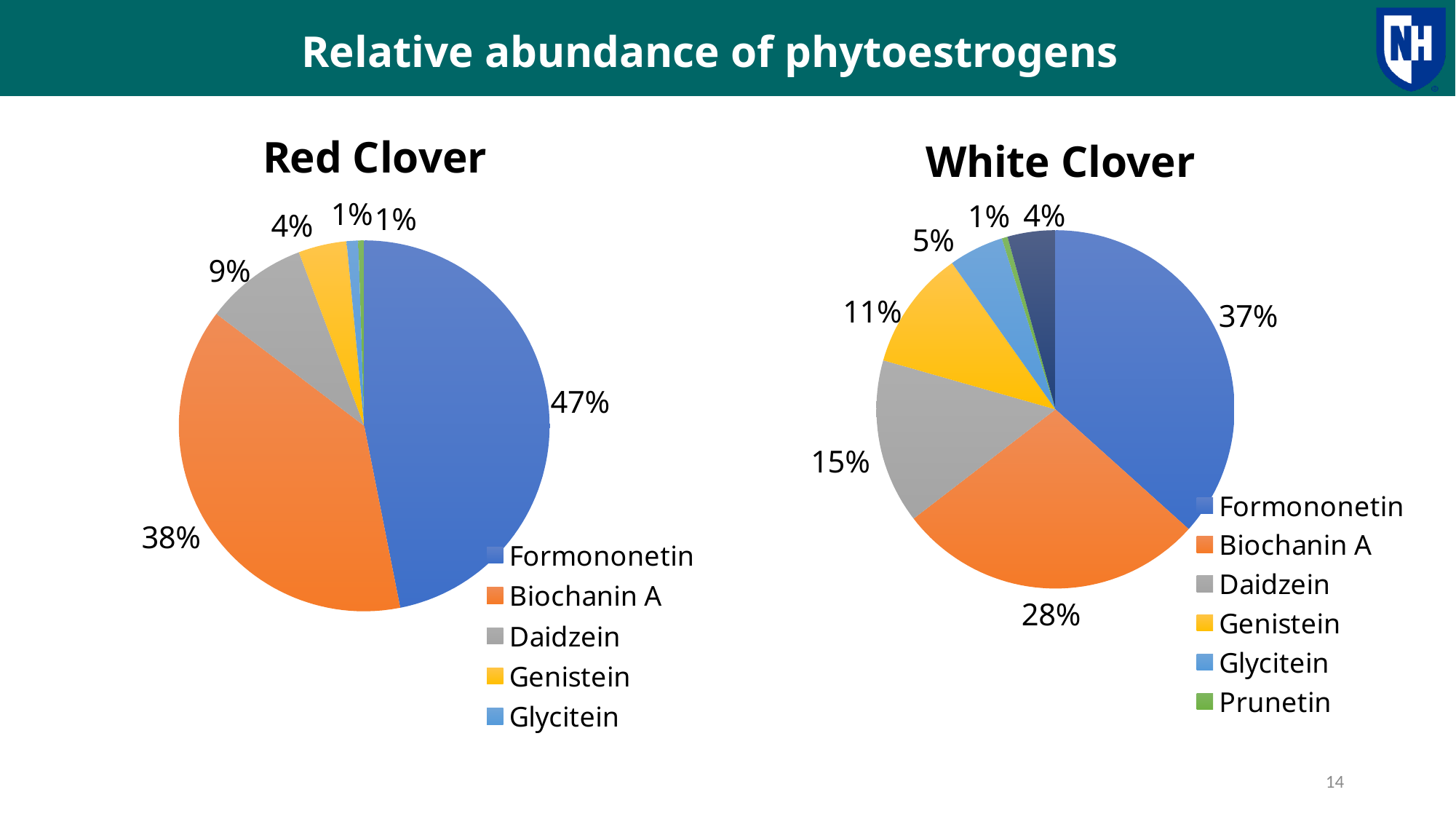
In the White Clover pie chart, what share does Daidzein have? 15% In the Red Clover pie chart, what percentage is Biochanin A? 38% In the White Clover pie chart, what percentage is Glycitein? 5% In the White Clover pie chart, what percentage is Prunetin? 1% Is the Daidzein share larger in the Red Clover chart or the White Clover chart? White Clover In the Red Clover pie chart, what share does Formononetin have? 47% How many entries does the legend of the White Clover pie chart list? 6 What type of chart is used for Red Clover and White Clover? Pie chart In the Red Clover pie chart, which phytoestrogen has the largest share? Formononetin In the White Clover pie chart, what percentage is Genistein? 11% How many entries does the legend of the Red Clover pie chart list? 5 In the Red Clover pie chart, how many percentage points larger is Formononetin than Biochanin A? 9 percentage points